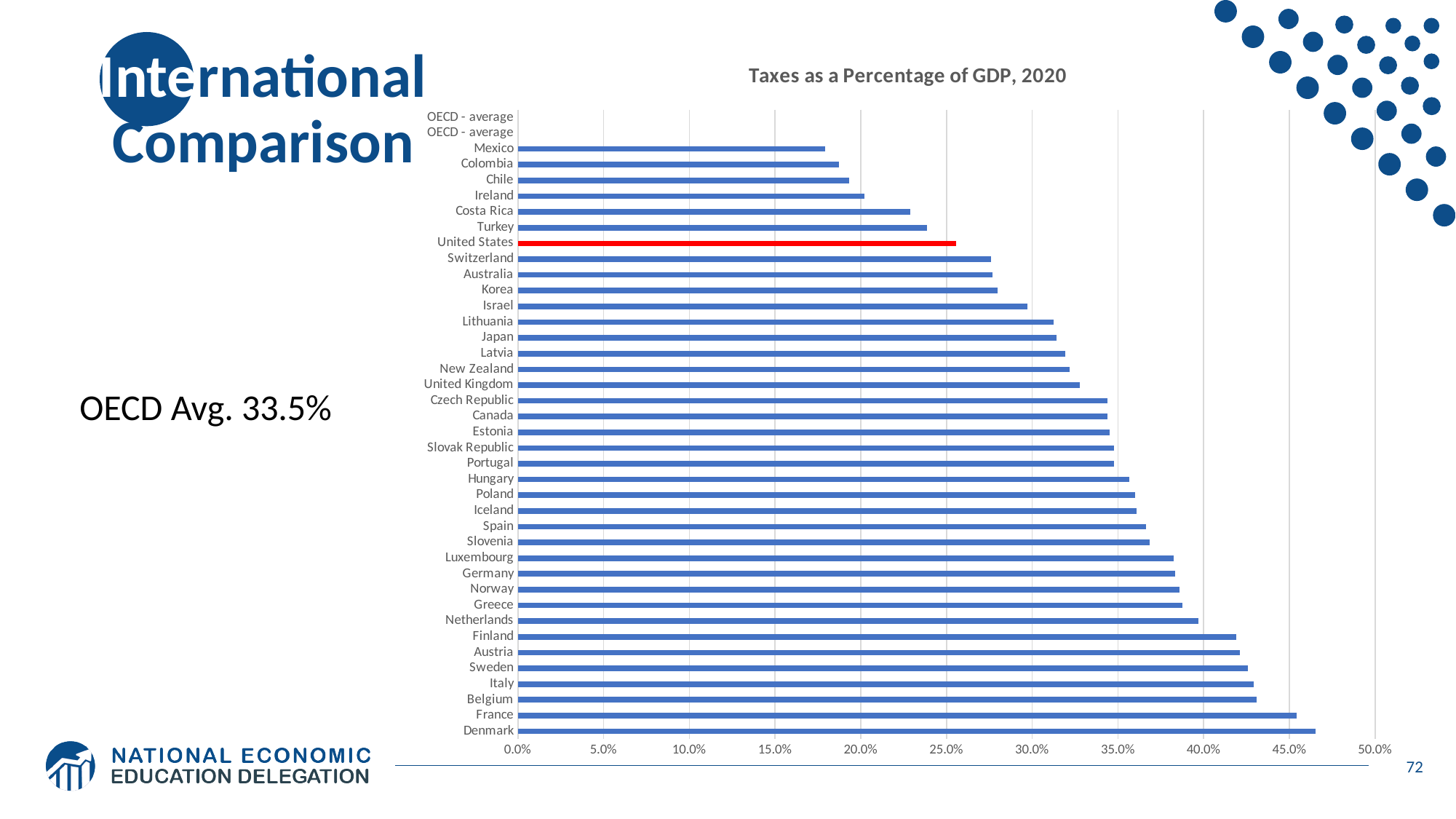
Which country has the highest taxes as a percentage of GDP in the chart? Denmark Which country's bar is highlighted in red? United States Is the value for Mexico greater or less than 20.0%? less Which has a higher value, Sweden or Turkey? Sweden Is the value for the United States greater or less than 30.0%? less Which country has the lowest taxes as a percentage of GDP in the chart? Mexico Is the value for Korea greater or less than 30.0%? less What kind of chart is shown on the slide? bar chart Which has a higher value, Chile or Germany? Germany What is the title of the chart? Taxes as a Percentage of GDP, 2020